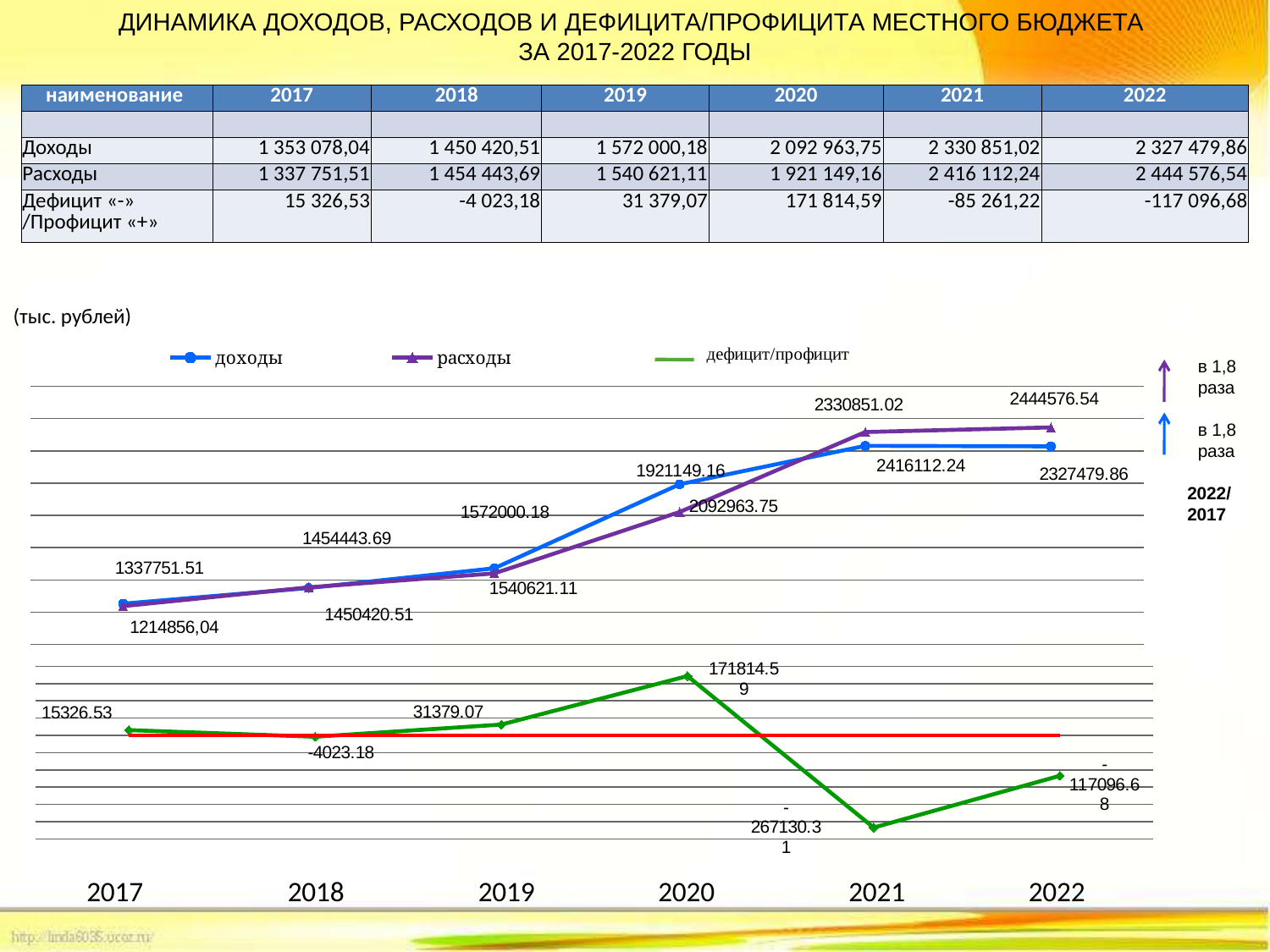
How many series does the chart legend list? 3 How many years are plotted along the x axis of the chart? 6 What value is labelled for дефицит/профицит in 2020 on the chart? 171814.59 Does the расходы line rise or fall from 2017 to 2022? rise What is the difference between the labelled доходы and расходы values for 2019 on the chart? 31379.07 What kind of chart is shown on the slide? line chart What value is labelled for доходы in 2019 on the chart? 1572000.18 In which year does the дефицит/профицит line reach its highest value? 2020 What value is labelled for расходы in 2018 on the chart? 1454443.69 In which year does the дефицит/профицит line reach its lowest value? 2021 What value is labelled for расходы in 2022 on the chart? 2444576.54 Which is larger in 2022 on the chart, доходы or расходы? расходы